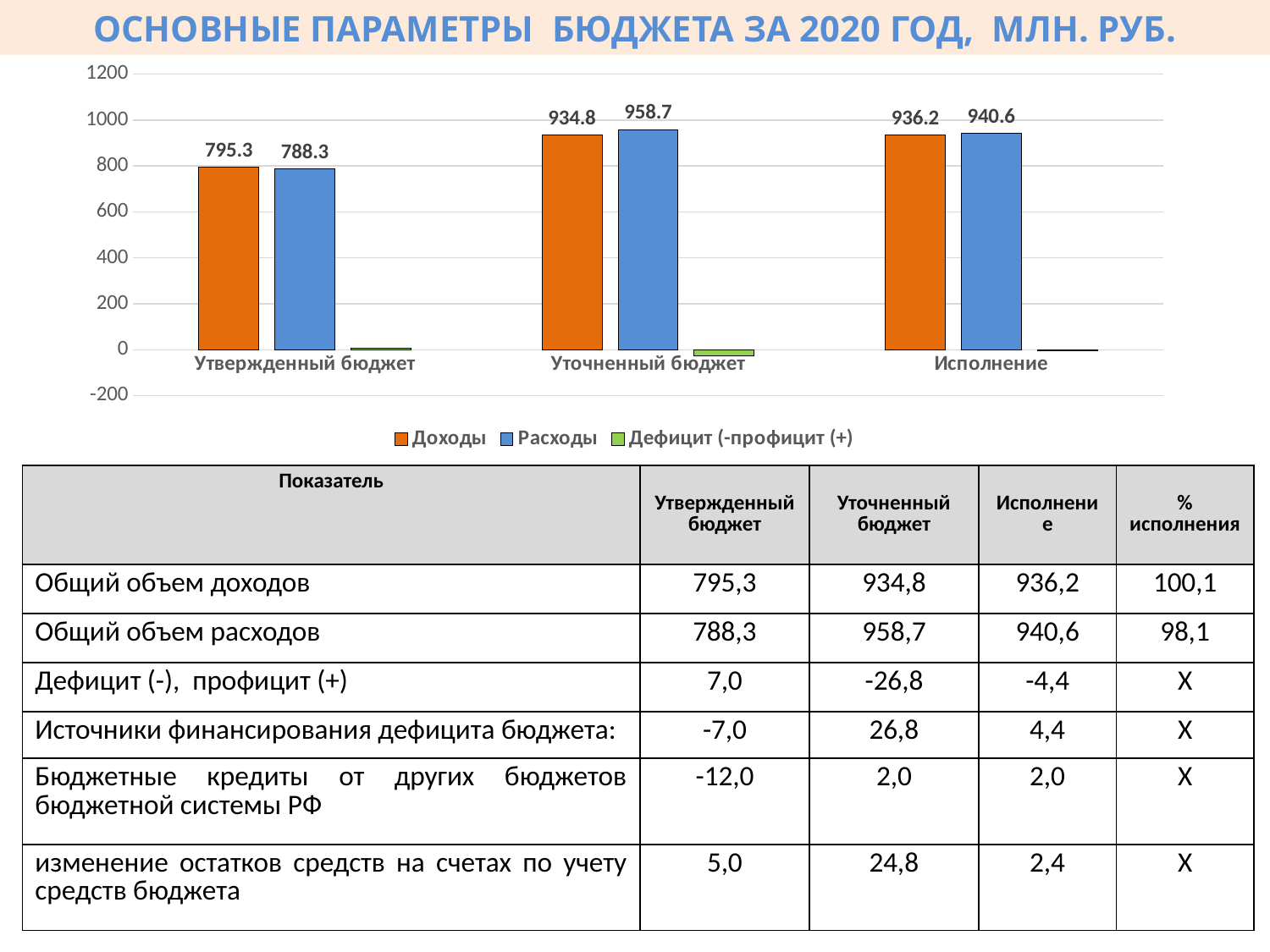
What is the value of Доходы for Исполнение? 936.2 Which category has the lowest Доходы value? Утвержденный бюджет What type of chart is shown on the slide? bar chart What is the value of Расходы for Уточненный бюджет? 958.7 How many categories are shown on the x axis? 3 What is the value of Расходы for Утвержденный бюджет? 788.3 Is the Доходы value for Утвержденный бюджет greater or less than 800? less How many series does the legend list? 3 Which is larger for Утвержденный бюджет, Доходы or Расходы? Доходы What is the value of Доходы for Утвержденный бюджет? 795.3 Which category has the highest Расходы value? Уточненный бюджет What is the difference between Расходы and Доходы for Уточненный бюджет? 23.9